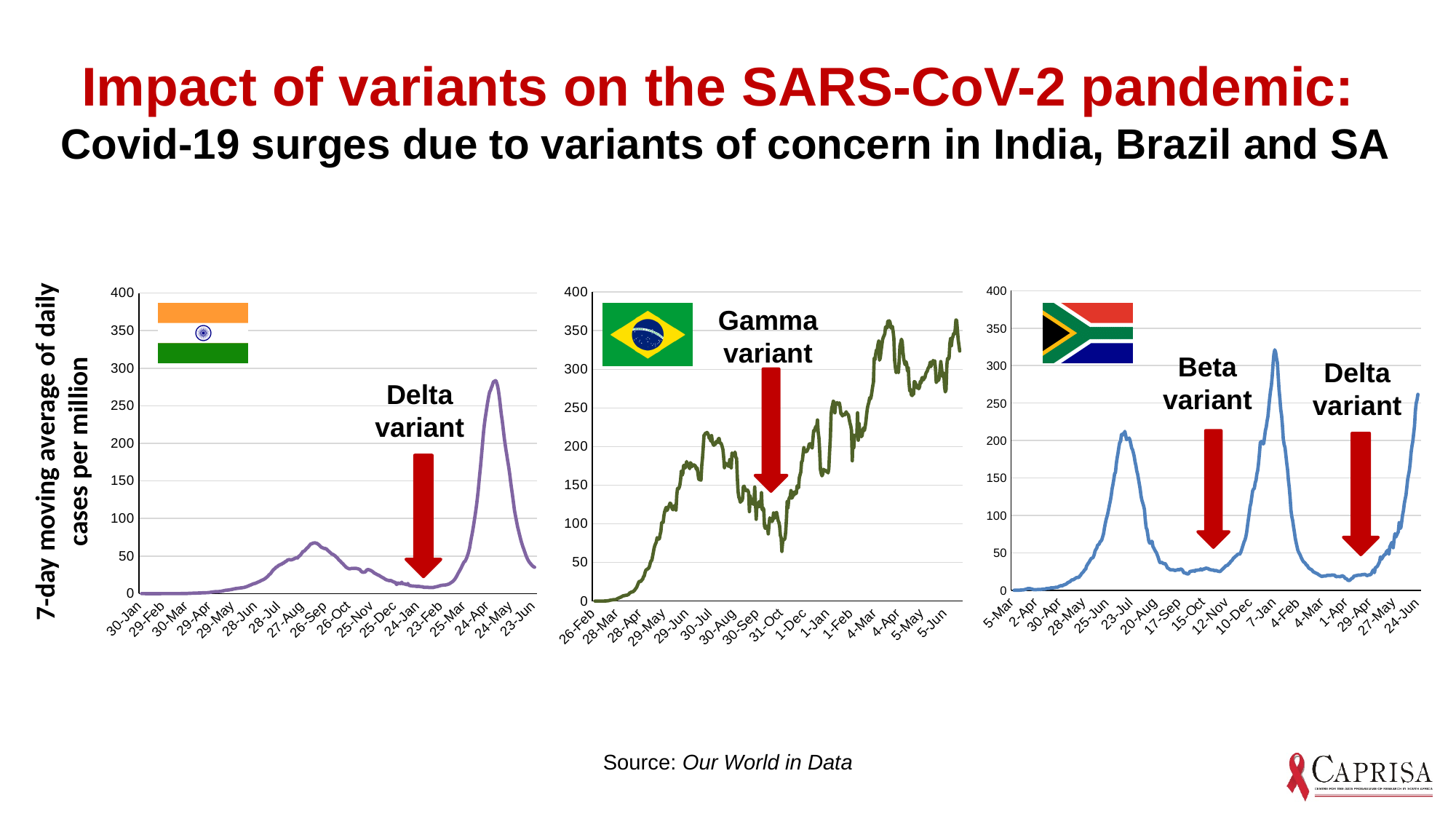
How many charts are shown on the slide? 3 On the right chart (South Africa), is the peak value around 23-Jul greater or less than 150? greater On the left chart (India), which peak is larger: the one around 26-Sep or the one around 24-Apr? 24-Apr On the right chart (South Africa), is the peak value around 7-Jan greater or less than 250? greater On the left chart (India), is the peak value around 24-Apr greater or less than 250? greater What kind of chart is the left chart (India)? line chart Which variant is annotated on the left chart (India)? Delta variant Which two variants are annotated on the right chart (South Africa)? Beta variant and Delta variant On the right chart (South Africa), which is larger: the value at 7-Jan or the value at 4-Mar? 7-Jan On the middle chart (Brazil), do the values overall rise or fall from 26-Feb to 5-Jun? rise